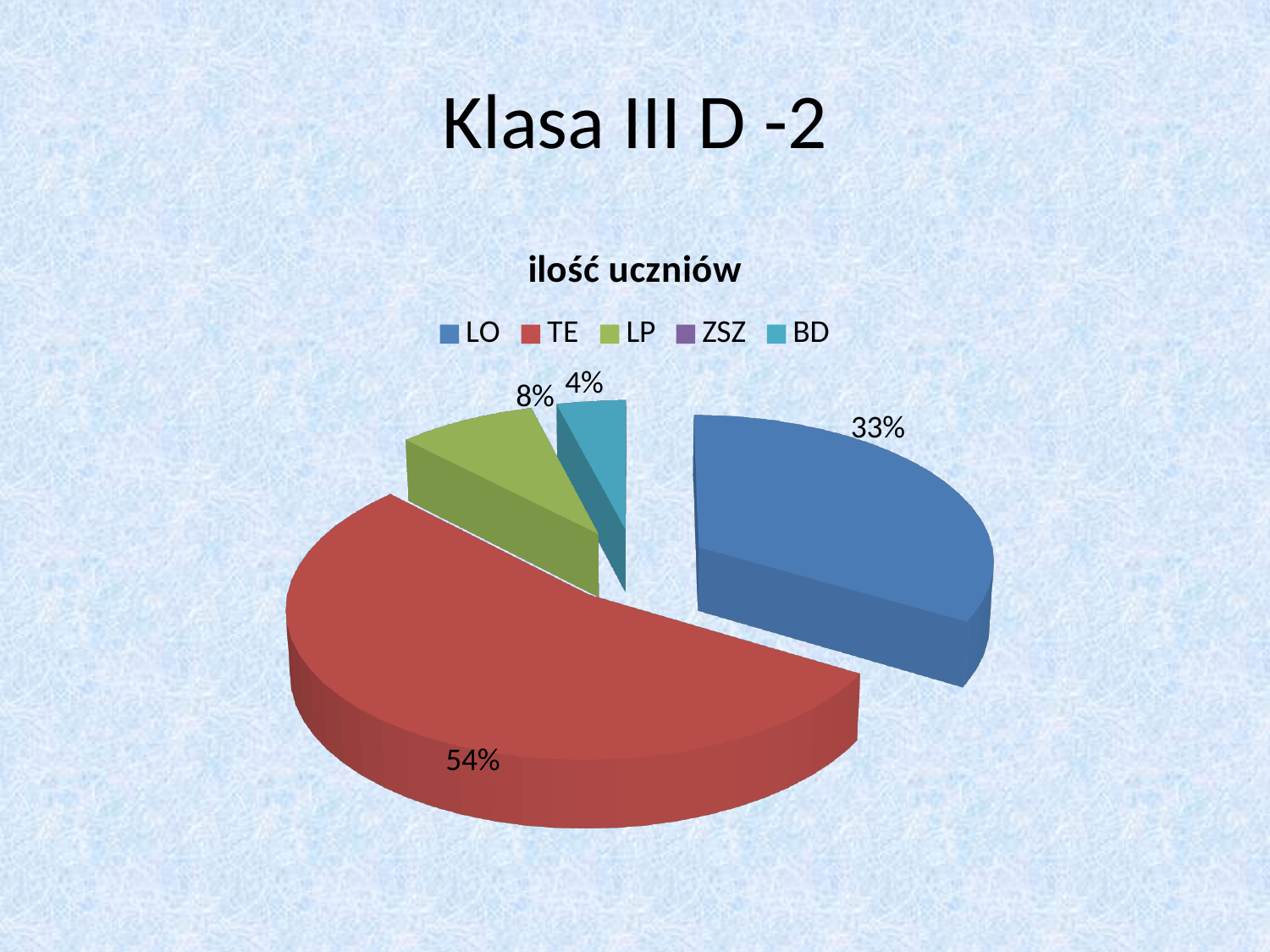
What share of the pie does TE have? 54% What kind of chart is shown on the slide? pie chart Which is larger, the slice for LO or the slice for TE? TE What is the title of the chart? ilość uczniów What is the difference in percentage points between the TE slice and the LO slice? 21% What share of the pie does BD have? 4% Which is larger, the slice for LP or the slice for BD? LP How many entries does the legend list? 5 What share of the pie does LP have? 8% What is the difference in percentage points between the LP slice and the BD slice? 4% Which category has the largest slice of the pie? TE